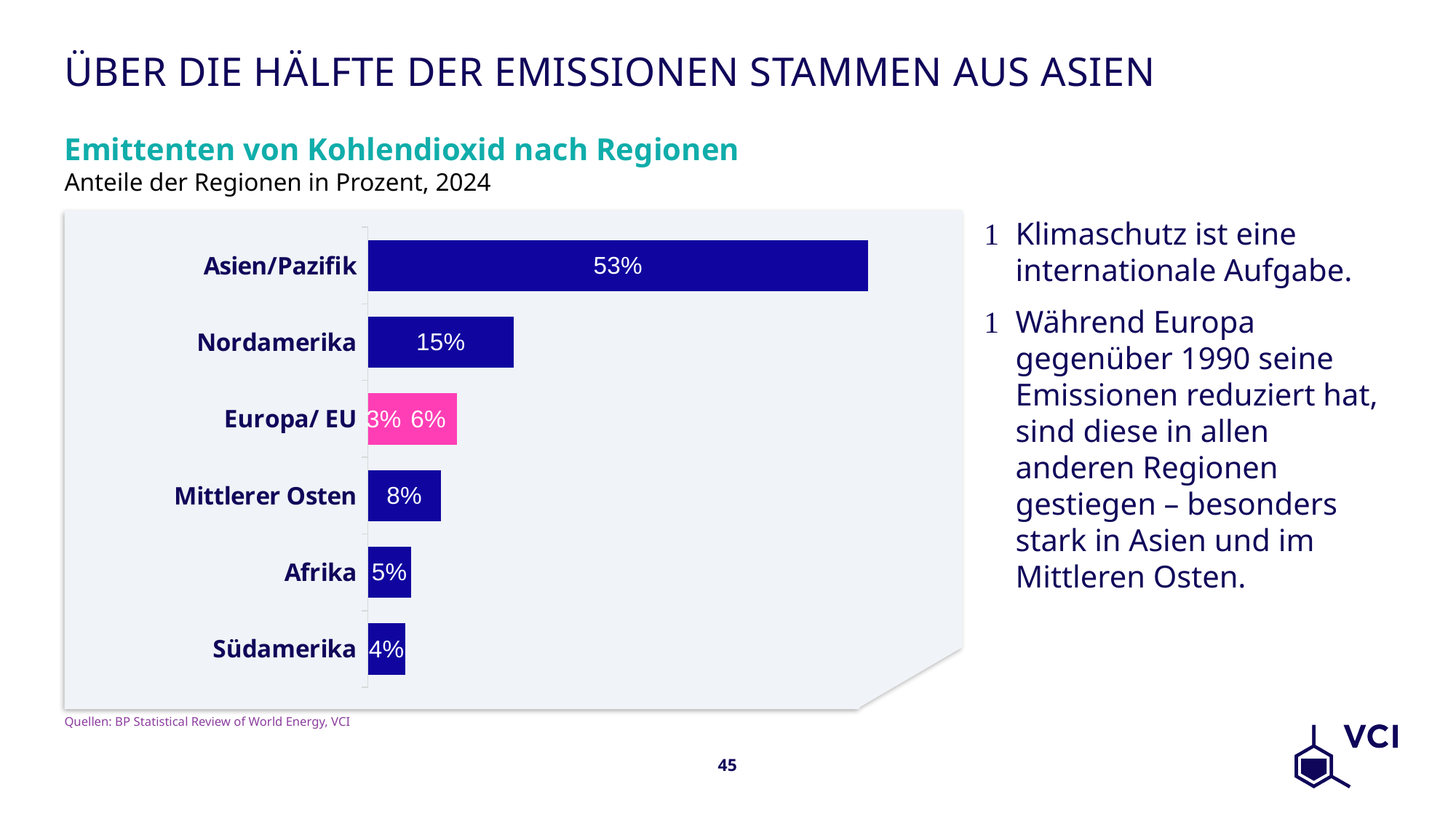
What is the difference between the shares of Nordamerika and Mittlerer Osten? 7 percentage points What is the value shown for Nordamerika? 15% How many regions are shown in the chart? 6 What is the value for Afrika in the chart? 5% Which region has the highest share of emissions in the chart? Asien/Pazifik What share is shown for Mittlerer Osten? 8% Which region has the lowest share of emissions in the chart? Südamerika What share is shown for Südamerika? 4% What kind of chart is shown on the slide? Bar chart Which has the larger share, Mittlerer Osten or Afrika? Mittlerer Osten How many percentage points higher is the share of Asien/Pazifik than that of Nordamerika? 38 percentage points What share of carbon dioxide emissions does the chart show for Asien/Pazifik? 53%